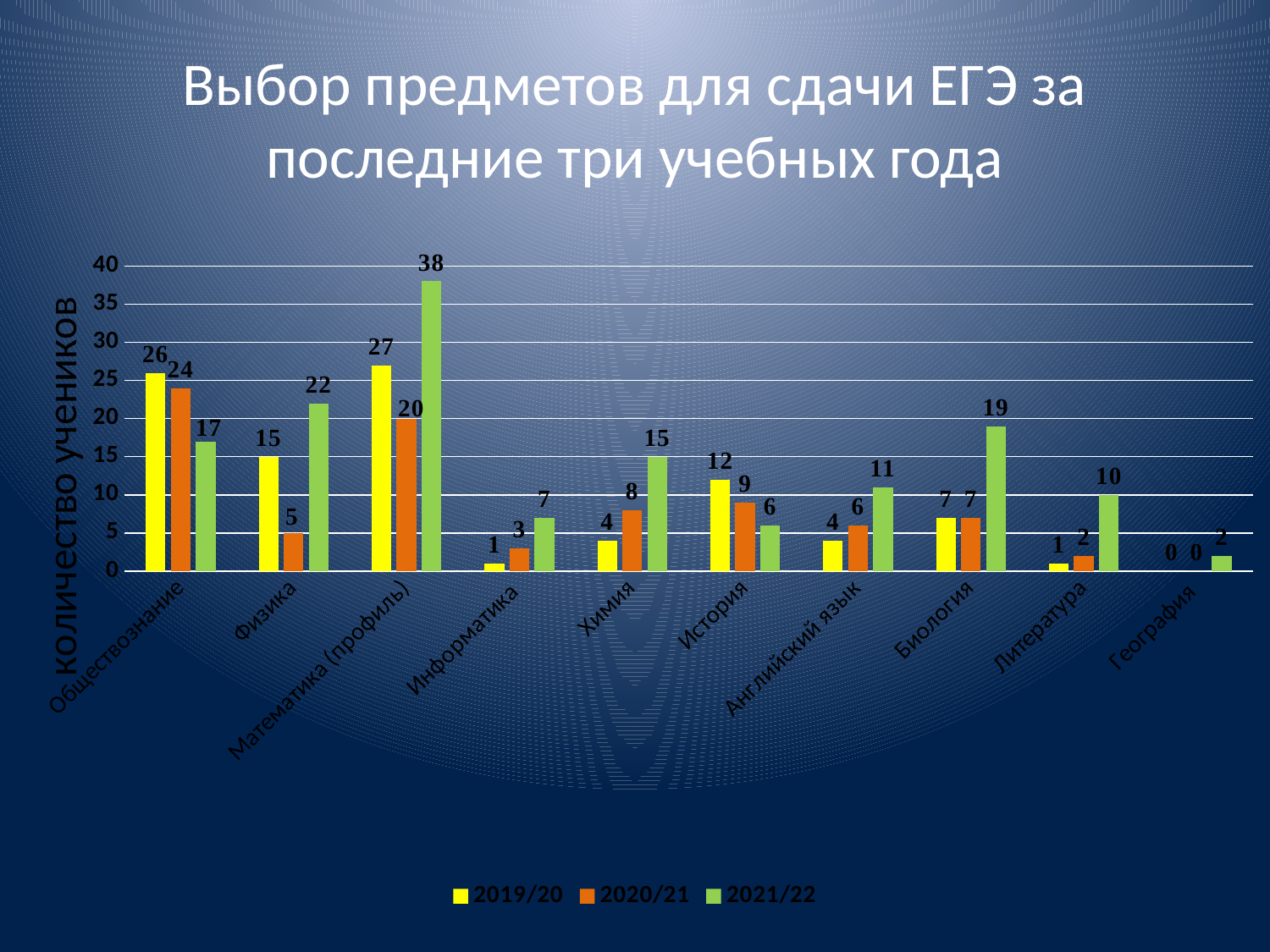
Which is larger for История: the 2019/20 value or the 2021/22 value? 2019/20 Does the value for Химия in the 2021/22 series rise or fall compared with 2019/20? Rise What is the difference between the 2021/22 and 2019/20 values for Физика? 7 What is the value for Биология in the 2019/20 series? 7 Which subject has the lowest value in the 2019/20 series? География Which subject has the highest value in the 2021/22 series? Математика (профиль) What is the label of the y axis? количество учеников How many subject categories are shown on the x axis? 10 What is the value for Математика (профиль) in the 2021/22 series? 38 How many series does the legend list? 3 What is the value for Обществознание in the 2020/21 series? 24 What type of chart is shown on the slide? Bar chart